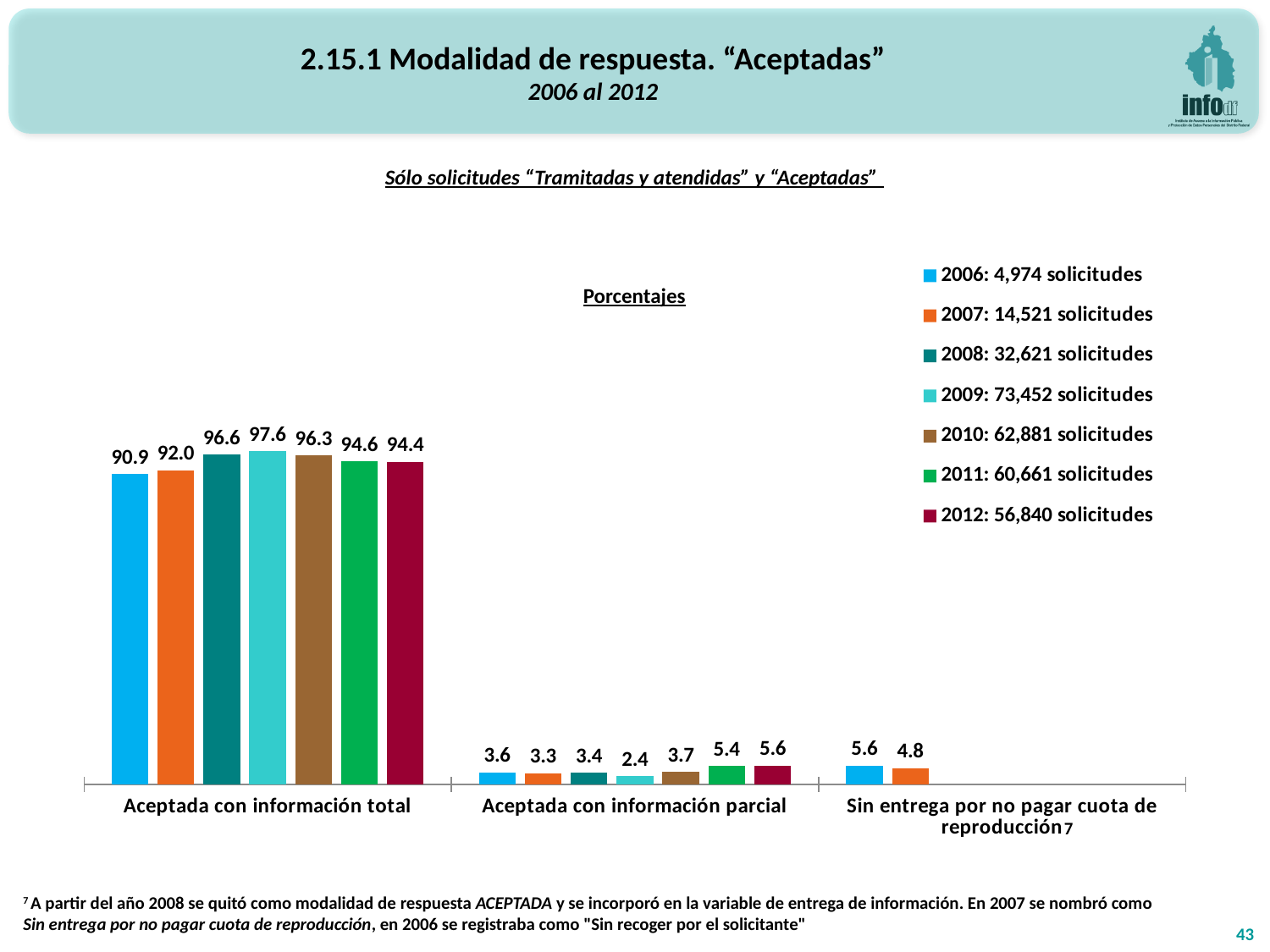
What is the value for 2009 in the "Aceptada con información total" category? 97.6 How many years have bars in the "Sin entrega por no pagar cuota de reproducción" category? 2 What is the difference between the 2009 and 2006 values in the "Aceptada con información total" category? 6.7 Which is larger in the "Aceptada con información parcial" category: the value for 2011 or the value for 2010? 2011 How many categories are shown on the x axis of the chart? 3 According to the legend, how many solicitudes were there in 2009? 73,452 What is the value for 2007 in the "Sin entrega por no pagar cuota de reproducción" category? 4.8 How many series does the legend list? 7 Which year has the lowest value in the "Aceptada con información parcial" category? 2009 What kind of chart is shown on the slide? Bar chart Which year has the highest value in the "Aceptada con información total" category? 2009 What is the value for 2012 in the "Aceptada con información parcial" category? 5.6